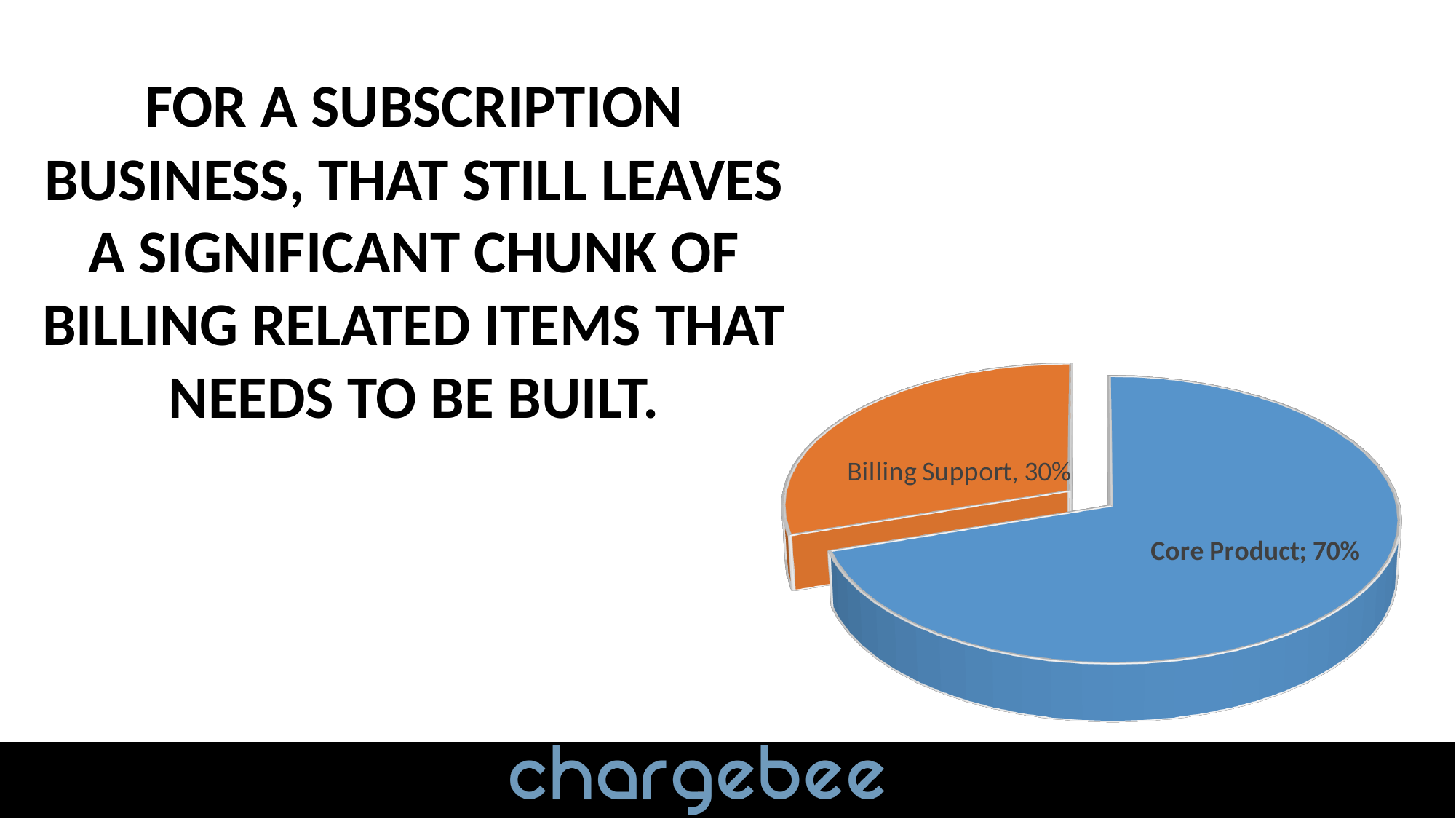
What colour is the Billing Support slice? orange What share of the pie does Core Product represent? 70% What colour is the Core Product slice? blue Which is larger, Core Product or Billing Support? Core Product What share of the pie does Billing Support represent? 30% Which slice of the pie is the largest? Core Product What kind of chart is shown on the slide? pie chart What is the difference in percentage points between Core Product and Billing Support? 40% How many slices does the pie chart have? 2 Which slice of the pie is the smallest? Billing Support